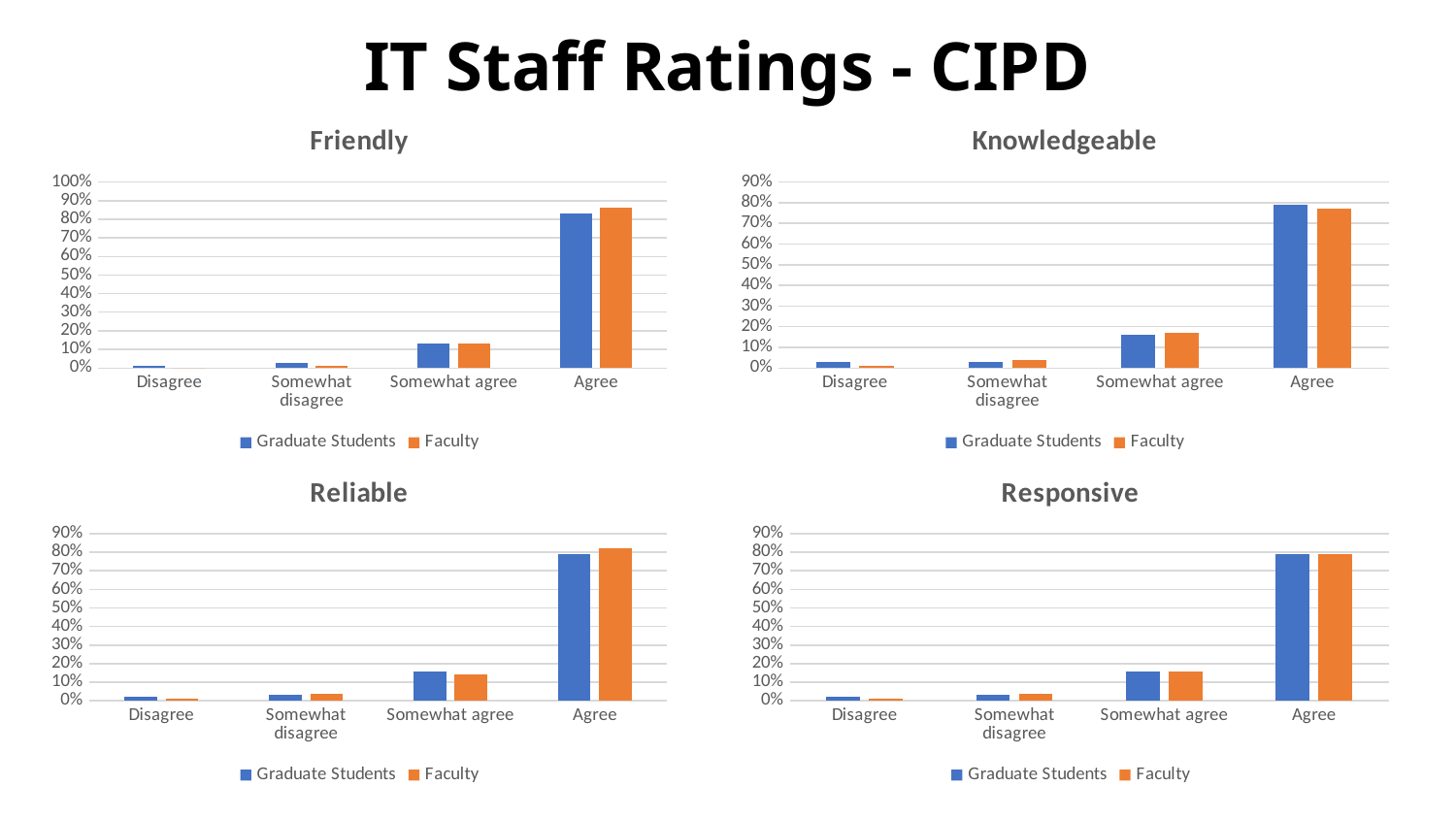
What are the two legend entries in the Responsive chart? Graduate Students and Faculty In the Reliable chart, is the Graduate Students value for Agree greater or less than 70%? greater In the Responsive chart, which category has the highest value for Faculty? Agree In the Friendly chart, is the Faculty value for Agree greater or less than 80%? greater In the Friendly chart, how many categories are shown on the x axis? 4 In the Reliable chart, is the Faculty value for Somewhat disagree greater or less than 10%? less In the Friendly chart, what kind of chart is shown? bar chart In the Friendly chart, how many series does the legend list? 2 In the Knowledgeable chart, which category has the lowest value for Faculty? Disagree In the Friendly chart, which category has the highest value for Graduate Students? Agree